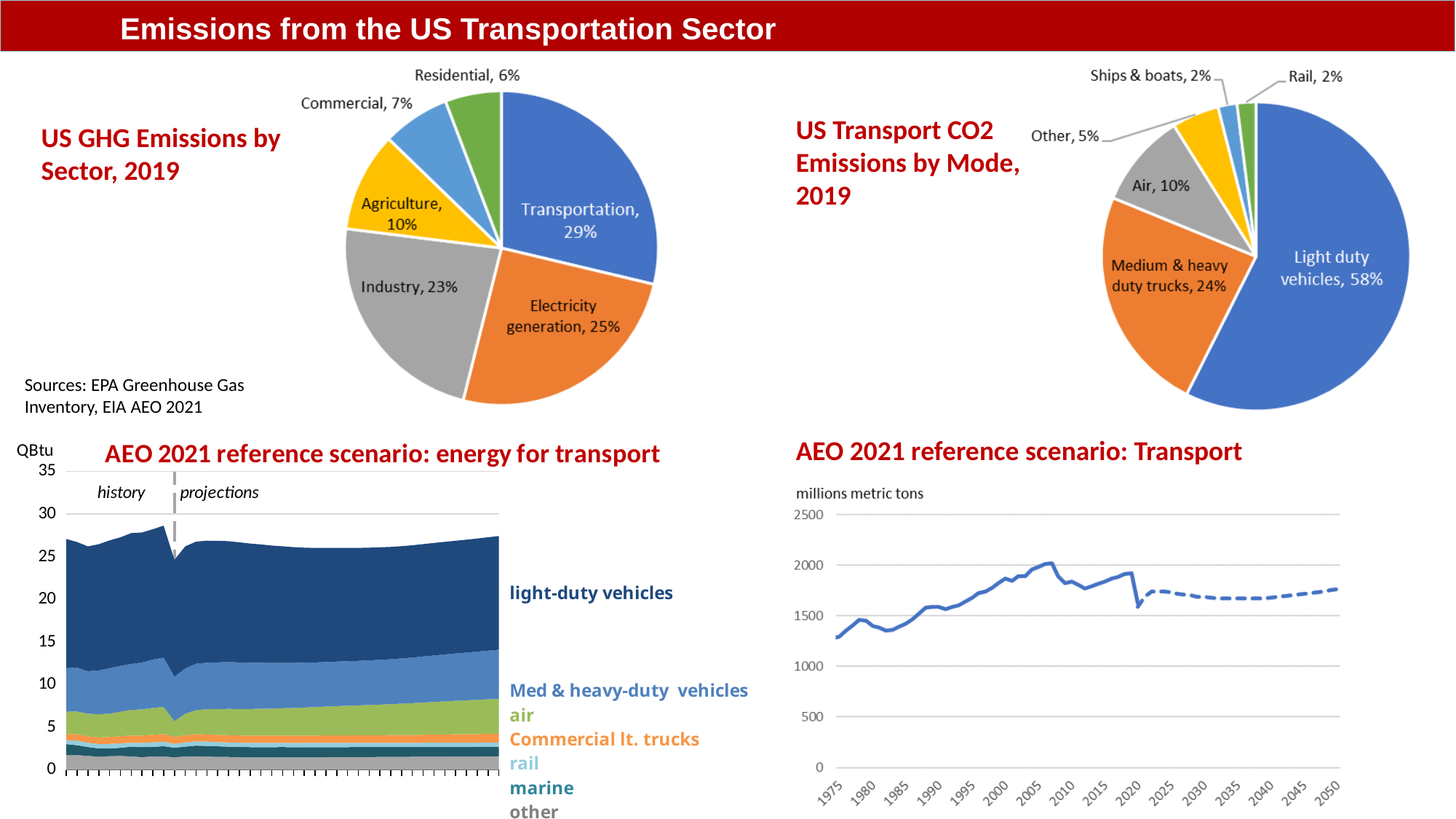
How many series does the legend of the AEO 2021 reference scenario: energy for transport chart list? 7 In the US Transport CO2 Emissions by Mode, 2019 pie chart, which is larger: Air or Other? Air How many slices does the US GHG Emissions by Sector, 2019 pie chart have? 6 In the AEO 2021 reference scenario: Transport line chart, is the value for 1975 greater or less than 1500? less What kind of chart is the US Transport CO2 Emissions by Mode, 2019 chart? Pie chart In the US GHG Emissions by Sector, 2019 pie chart, what is the difference between the Electricity generation and Industry shares? 2% In the US Transport CO2 Emissions by Mode, 2019 pie chart, what is the share for Medium & heavy duty trucks? 24% What unit is shown on the y axis of the AEO 2021 reference scenario: energy for transport chart? QBtu In the US Transport CO2 Emissions by Mode, 2019 pie chart, what share do Light duty vehicles have? 58% In the AEO 2021 reference scenario: Transport line chart, do values rise or fall from 1975 to 2005? rise In the US GHG Emissions by Sector, 2019 pie chart, which sector has the smallest share? Residential In the US GHG Emissions by Sector, 2019 pie chart, what share does Transportation have? 29%